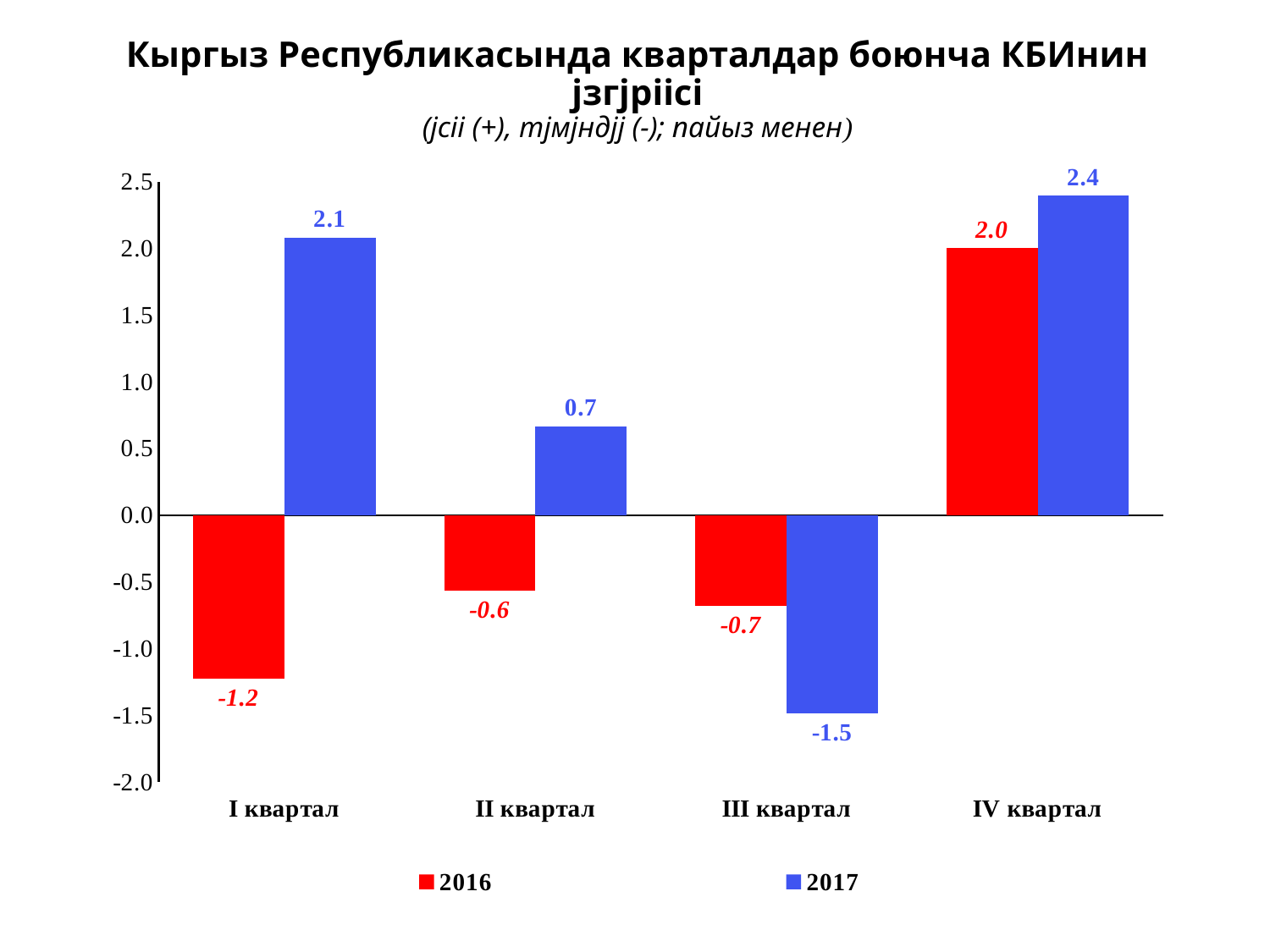
In which quarter is the 2016 value lowest? I квартал What is the value for 2016 in IV квартал? 2.0 In which quarter is the 2017 value highest? IV квартал What is the difference between the 2017 and 2016 values in I квартал? 3.3 Which colour represents the 2017 series? blue What is the value for 2017 in II квартал? 0.7 What is the value for 2017 in III квартал? -1.5 Which is larger in III квартал, the 2016 value or the 2017 value? 2016 What is the value for 2016 in I квартал? -1.2 How many quarters (categories) are shown on the x axis? 4 What kind of chart is shown on the slide? bar chart How many series does the legend list? 2